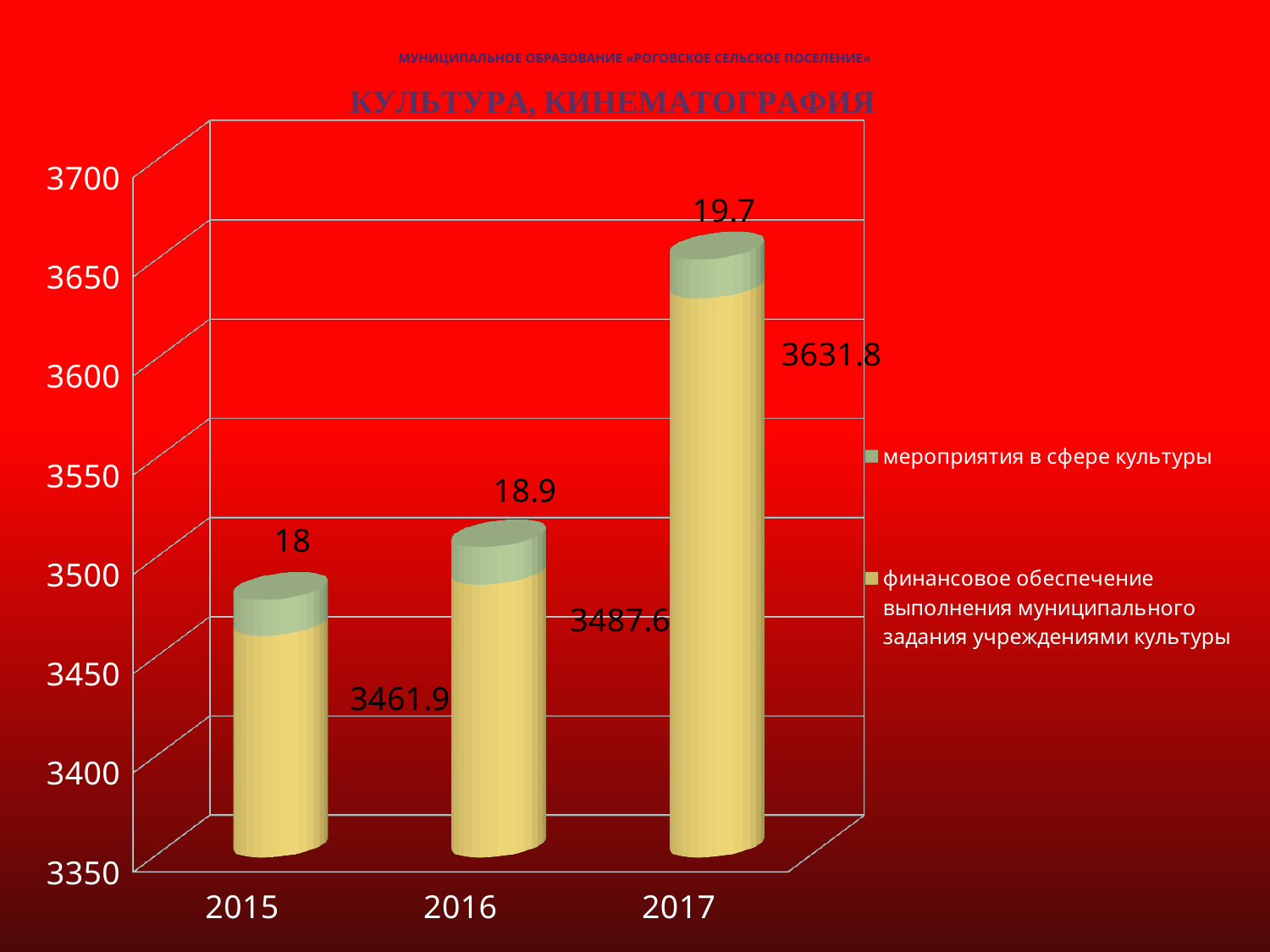
Does the value for "финансовое обеспечение выполнения муниципального задания учреждениями культуры" rise or fall from 2015 to 2017? Rise What is the difference between the "финансовое обеспечение выполнения муниципального задания учреждениями культуры" values for 2017 and 2015? 169.9 What is the value for "мероприятия в сфере культуры" in 2017? 19.7 What is the value for "мероприятия в сфере культуры" in 2015? 18 In which year is the value for "мероприятия в сфере культуры" the lowest? 2015 Which year has the larger value for "мероприятия в сфере культуры", 2016 or 2017? 2017 What kind of chart is shown on the slide? Stacked bar chart How many years are shown on the x axis? 3 In which year is the value for "финансовое обеспечение выполнения муниципального задания учреждениями культуры" the highest? 2017 What is the value for "финансовое обеспечение выполнения муниципального задания учреждениями культуры" in 2016? 3487.6 What is the value for "финансовое обеспечение выполнения муниципального задания учреждениями культуры" in 2017? 3631.8 How many series does the legend list? 2